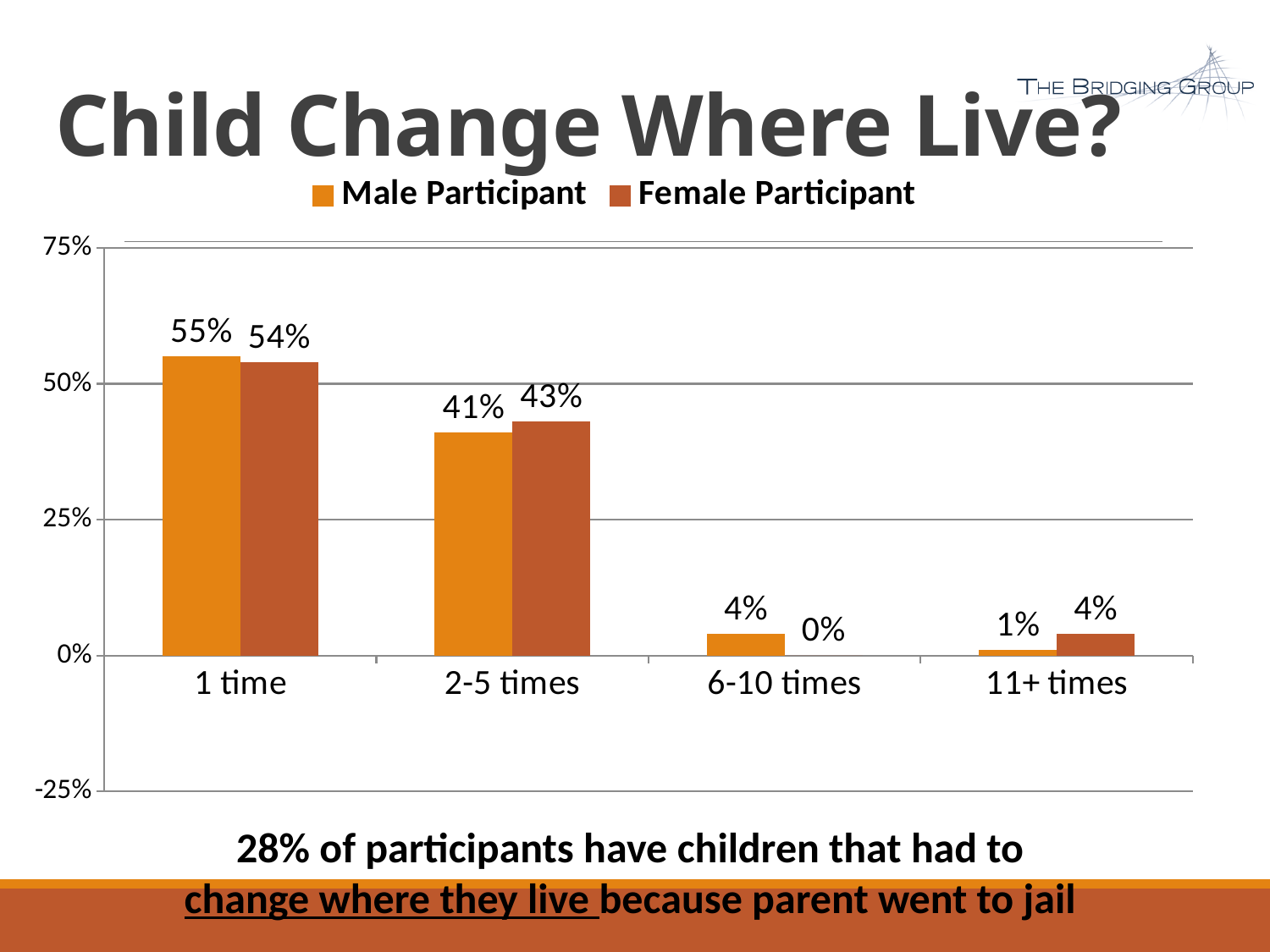
What is the value for Male Participant in the 11+ times category? 1% What is the value for Male Participant in the 1 time category? 55% How many series does the legend list? 2 What kind of chart is shown on the slide? bar chart What is the difference between the Male Participant and Female Participant values in the 2-5 times category? 2% What is the value for Female Participant in the 6-10 times category? 0% What is the value for Female Participant in the 2-5 times category? 43% How many categories are shown on the x axis? 4 Which category has the lowest value for Male Participant? 11+ times Which category has the highest value for Female Participant? 1 time In the 11+ times category, which is larger: Male Participant or Female Participant? Female Participant Is the value for Male Participant in the 2-5 times category greater or less than 50%? less